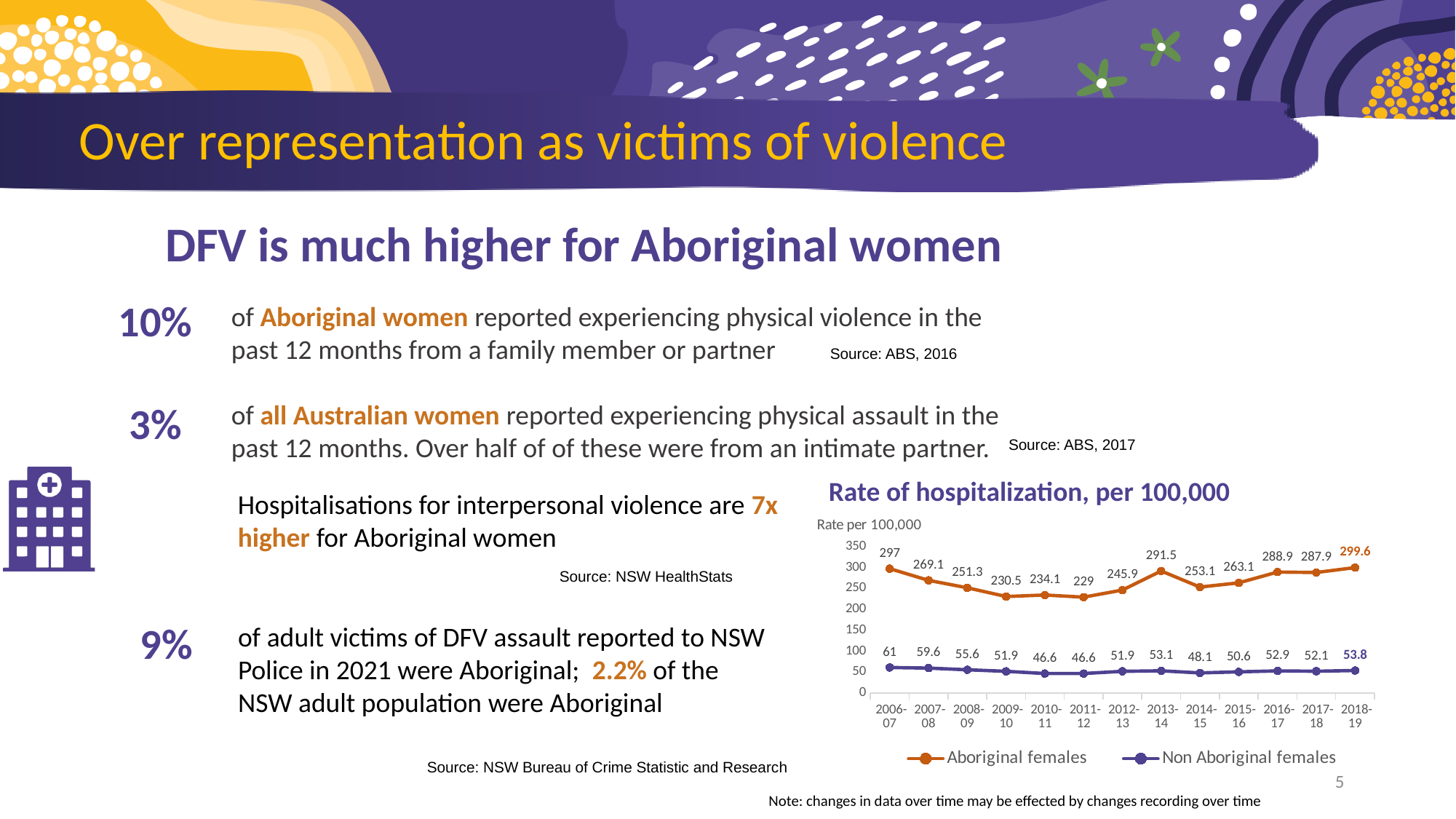
Which series has the higher hospitalization rate in 2010-11, Aboriginal females or Non Aboriginal females? Aboriginal females How many series does the legend of the hospitalization chart list? 2 Is the hospitalization rate for Non Aboriginal females in 2012-13 greater or less than 100? less In which period is the hospitalization rate for Aboriginal females lowest? 2011-12 How many time periods are plotted on the x axis of the hospitalization chart? 13 What is the hospitalization rate for Aboriginal females in 2013-14? 291.5 What is the hospitalization rate for Aboriginal females in 2018-19? 299.6 What type of chart is used for 'Rate of hospitalization, per 100,000'? line chart What is the difference between the Aboriginal females and Non Aboriginal females hospitalization rates in 2018-19? 245.8 In which period is the hospitalization rate for Non Aboriginal females highest? 2006-07 What is the label on the vertical axis of the hospitalization chart? Rate per 100,000 What is the hospitalization rate for Non Aboriginal females in 2006-07? 61